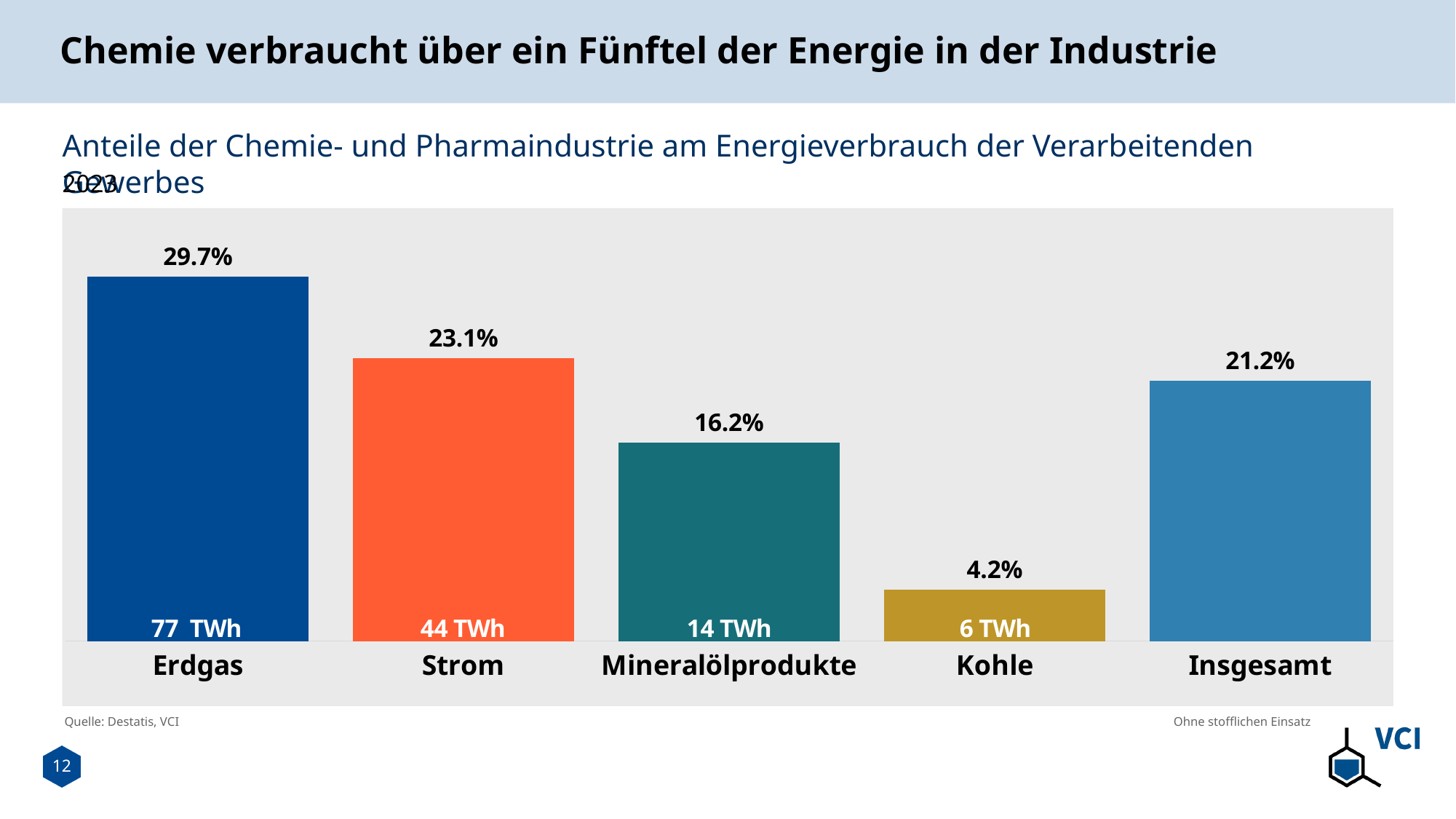
How many TWh are shown inside the Mineralölprodukte bar? 14 TWh What is the percentage share shown for Erdgas? 29.7% What kind of chart is shown on the slide? Bar chart How many TWh are shown inside the Erdgas bar? 77 TWh What is the percentage share shown for Kohle? 4.2% How many categories are shown on the x axis? 5 Which has a larger percentage share, Mineralölprodukte or Insgesamt? Insgesamt Which category has the lowest percentage share? Kohle What is the difference in percentage points between the Erdgas share and the Strom share? 6.6 What source is cited below the chart? Destatis, VCI What is the percentage share shown for Strom? 23.1% Which category has the highest percentage share? Erdgas